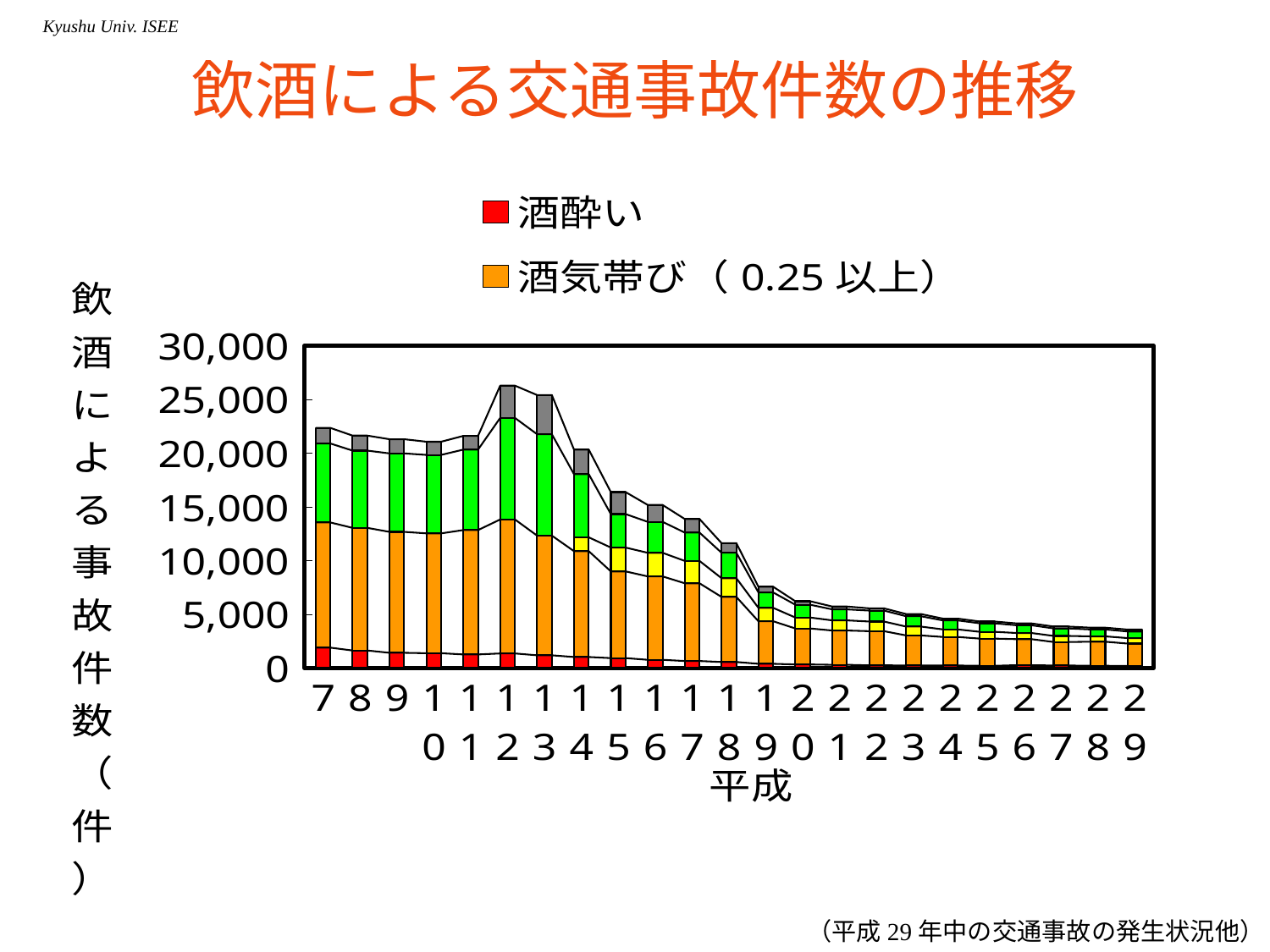
Which year (平成) has the tallest stacked bar? 平成12 Which has the larger total, 平成12 or 平成13? 平成12 What is the title of the chart? 飲酒による交通事故件数の推移 How many years (categories) are plotted along the x axis? 23 Is the total for 平成29 greater or less than 5,000? less What kind of chart is shown on the slide? Stacked bar chart Is the total for 平成7 greater or less than 20,000? greater Overall, do the totals rise or fall from 平成12 to 平成29? fall Is the total for 平成15 greater or less than 15,000? greater How many series does the legend list? 2